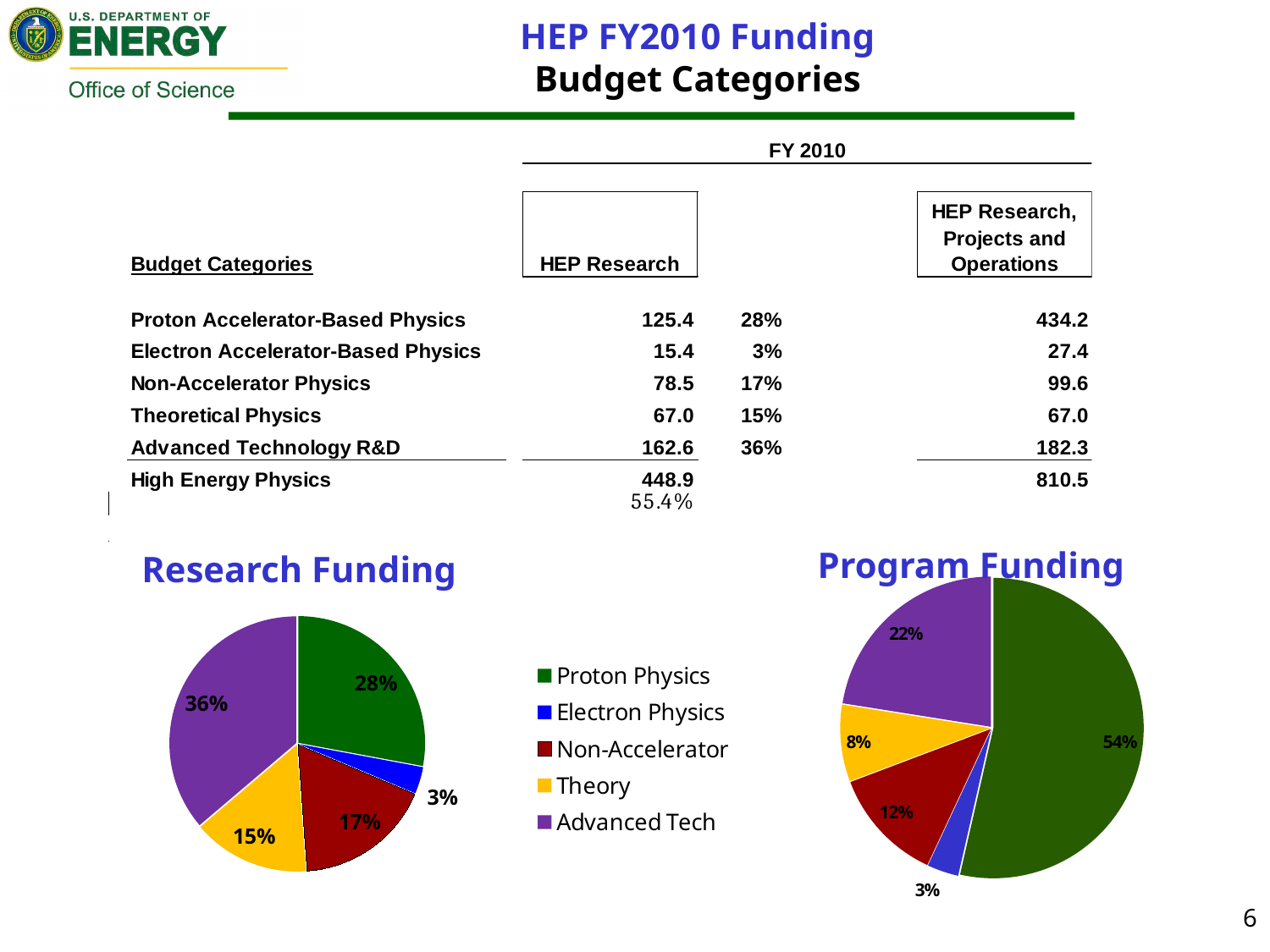
In the Program Funding chart, what is the difference between the Advanced Tech share and the Non-Accelerator share? 10% In the Research Funding chart, what share does Proton Physics have? 28% In the Research Funding chart, which is larger, the Non-Accelerator share or the Theory share? Non-Accelerator In the Program Funding chart, which category has the largest share? Proton Physics In the Research Funding chart, which category has the smallest share? Electron Physics What colour represents Theory in the pie charts? yellow How many categories does the legend list for the pie charts? 5 In the Program Funding chart, what share does Theory have? 8% In the Program Funding chart, what share does Proton Physics have? 54% In the Research Funding chart, which category has the largest share? Advanced Tech What type of chart is the Research Funding chart? pie chart